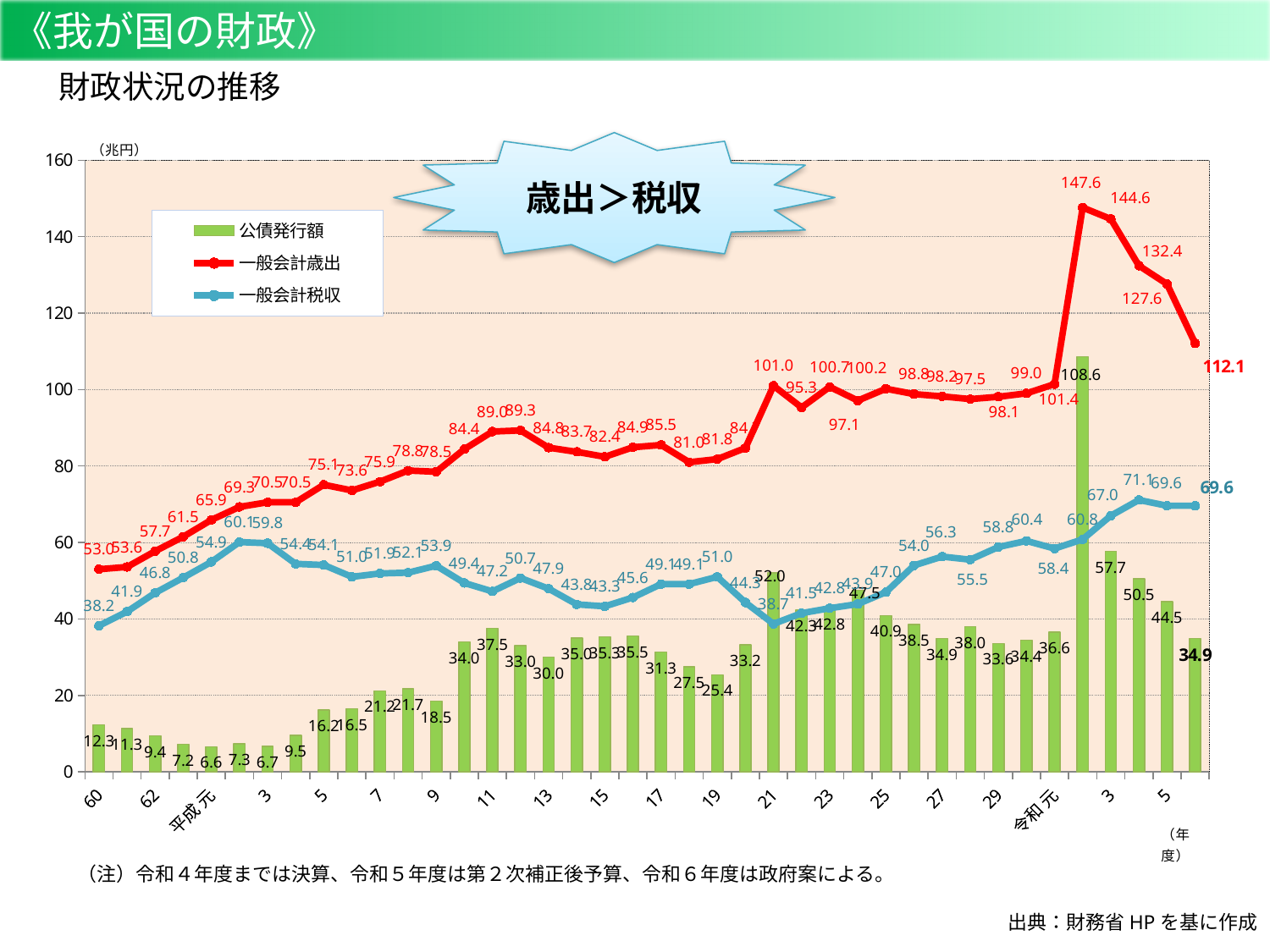
What kind of chart is shown on the slide? A combined bar and line chart How many series does the legend list? 3 What is the highest value of the 公債発行額 bars? 108.6 What is the lowest value of the 公債発行額 bars? 6.6 At the rightmost point, what is the difference between 一般会計歳出 (112.1) and 一般会計税収 (69.6)? 42.5 What is the value of 一般会計歳出 at the rightmost point of the chart? 112.1 What is the value of 一般会計税収 at the first point (60) on the x axis? 38.2 What is the highest value reached by the 一般会計税収 line? 71.1 What is the value of 公債発行額 at 21 on the x axis? 52.0 Is the peak value of the 一般会計歳出 line greater or less than 140? greater What is the highest value reached by the 一般会計歳出 line? 147.6 At 令和元, which is larger: 一般会計歳出 or 一般会計税収? 一般会計歳出